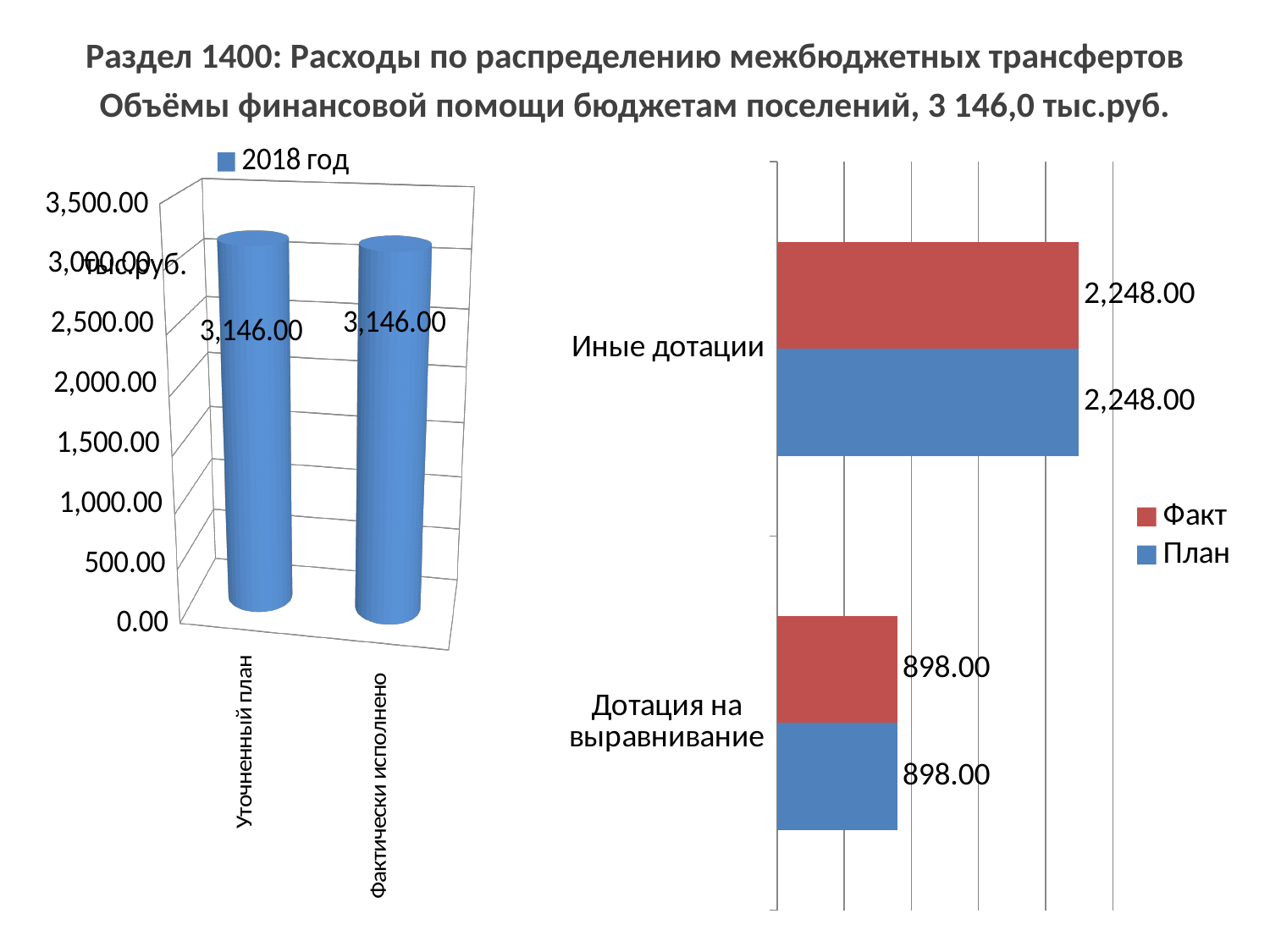
In the right chart, which category has the highest Факт value? Иные дотации In the right chart, how many series does the legend list? 2 In the left chart, how many categories are shown on the x axis? 2 What kind of chart is the right chart? Bar chart In the right chart, which is larger: the Факт value for Иные дотации or the Факт value for Дотация на выравнивание? Иные дотации In the right chart, what is the difference between the План values for Иные дотации and Дотация на выравнивание? 1,350.00 In the left chart, what is the value for Уточненный план? 3,146.00 In the left chart, what series does the legend list? 2018 год In the left chart, what is the value for Фактически исполнено? 3,146.00 In the right chart, what is the План value for Иные дотации? 2,248.00 In the left chart, what is the difference between the values for Уточненный план and Фактически исполнено? 0.00 In the right chart, what is the Факт value for Дотация на выравнивание? 898.00